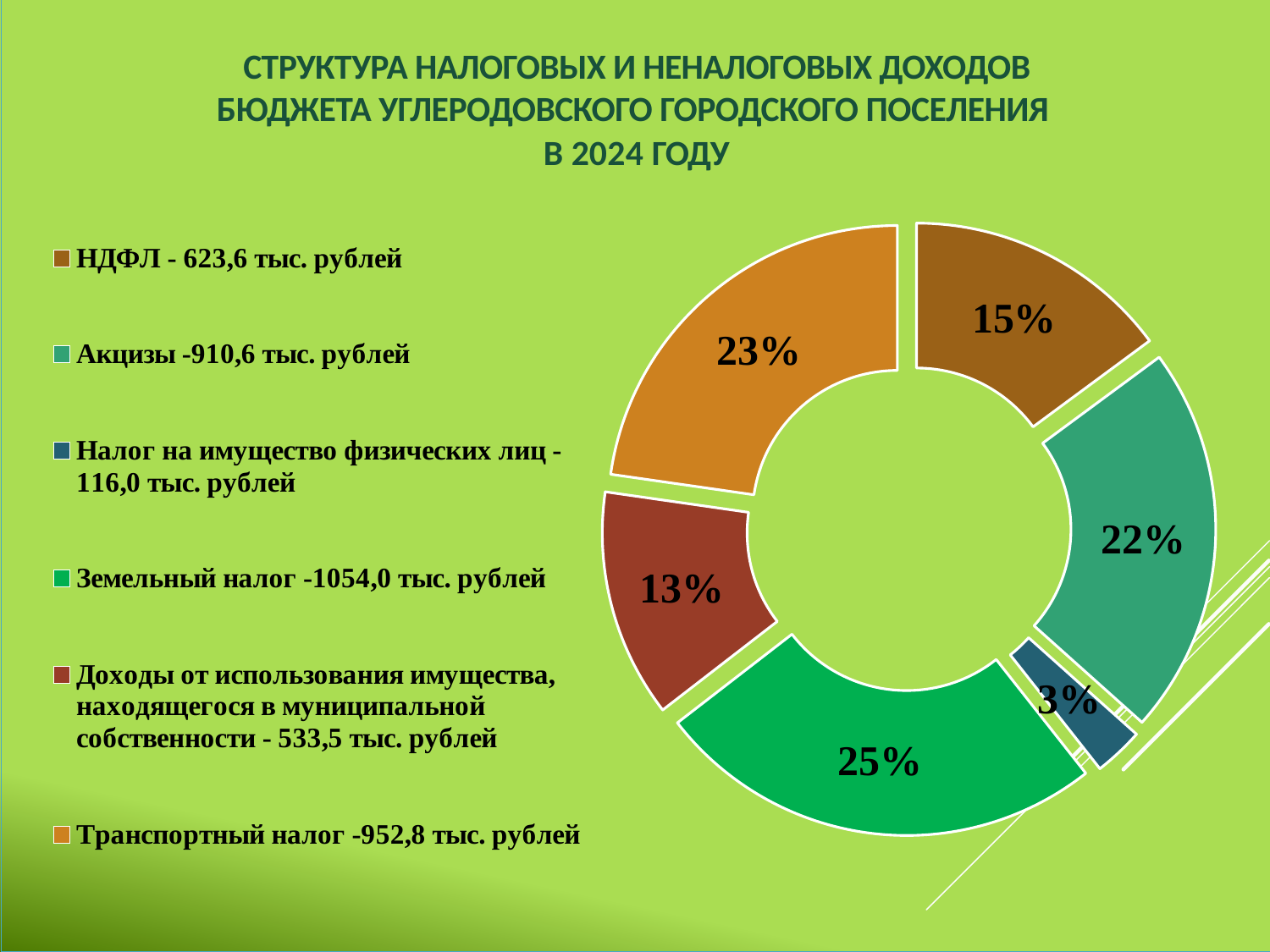
What share of the chart does Акцизы have? 22% What share of the chart does Земельный налог have? 25% What share of the chart does НДФЛ have? 15% What kind of chart is shown on the slide? Doughnut (pie) chart What is the difference in percentage points between the shares of Земельный налог and Доходы от использования имущества, находящегося в муниципальной собственности? 12 Which has the larger share, Акцизы or НДФЛ? Акцизы Which category has the largest share of the chart? Земельный налог How many categories does the chart show? 6 According to the legend, what is the amount for Транспортный налог? 952,8 тыс. рублей Which category has the smallest share of the chart? Налог на имущество физических лиц